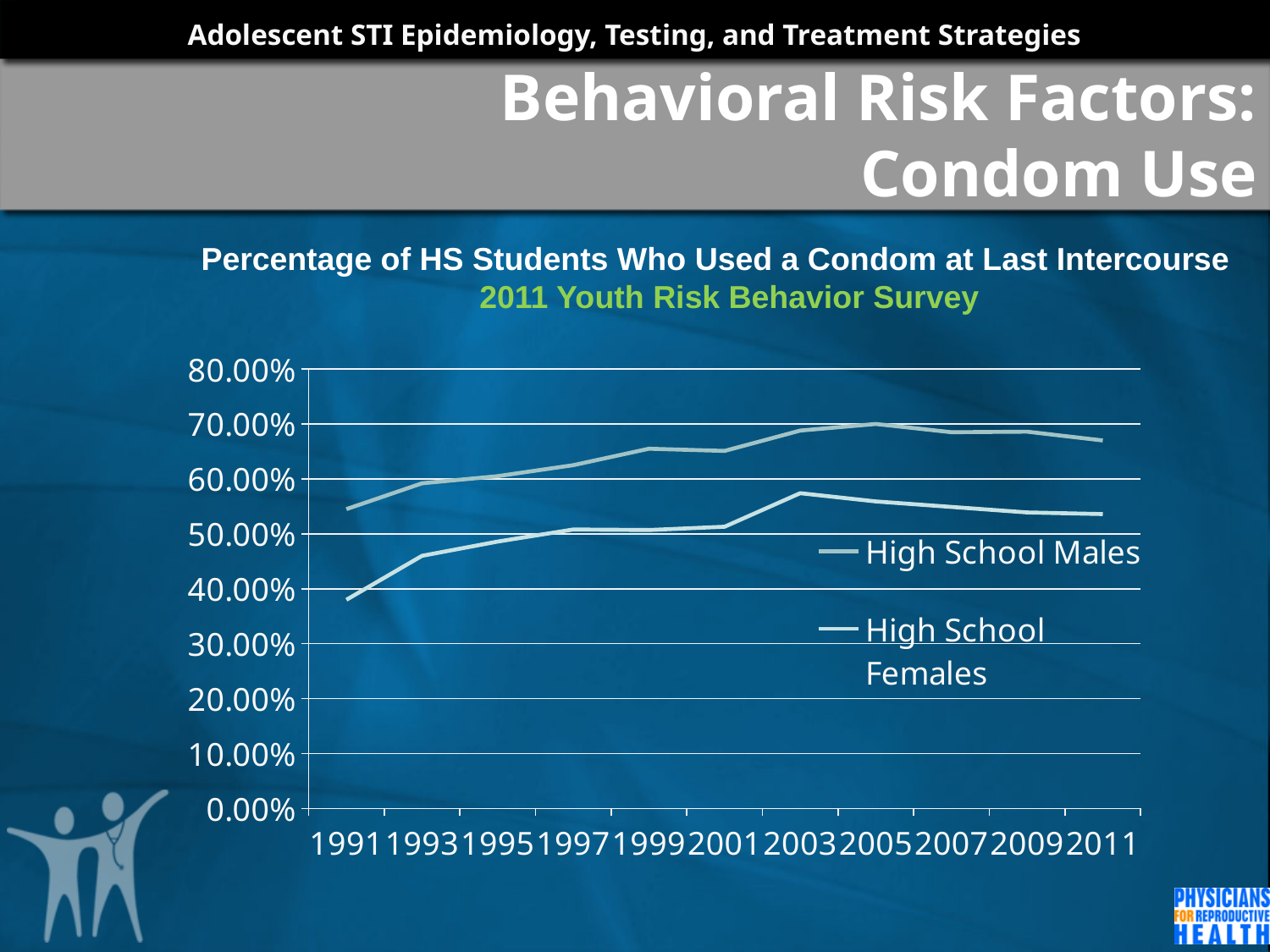
Which series has the higher value in 1991, High School Males or High School Females? High School Males What survey is named in the chart's subtitle? 2011 Youth Risk Behavior Survey In which year is the value for High School Males lowest? 1991 In which year is the value for High School Females lowest? 1991 How many series does the legend list? 2 Is the value for High School Females in 2003 greater or less than 50.00%? greater How many years are plotted along the x axis? 11 What kind of chart is shown on the slide? line chart Overall, does the value for High School Females rise or fall from 1991 to 2011? rise Is the value for High School Females in 1991 greater or less than 40.00%? less Is the value for High School Males in 2011 greater or less than 60.00%? greater